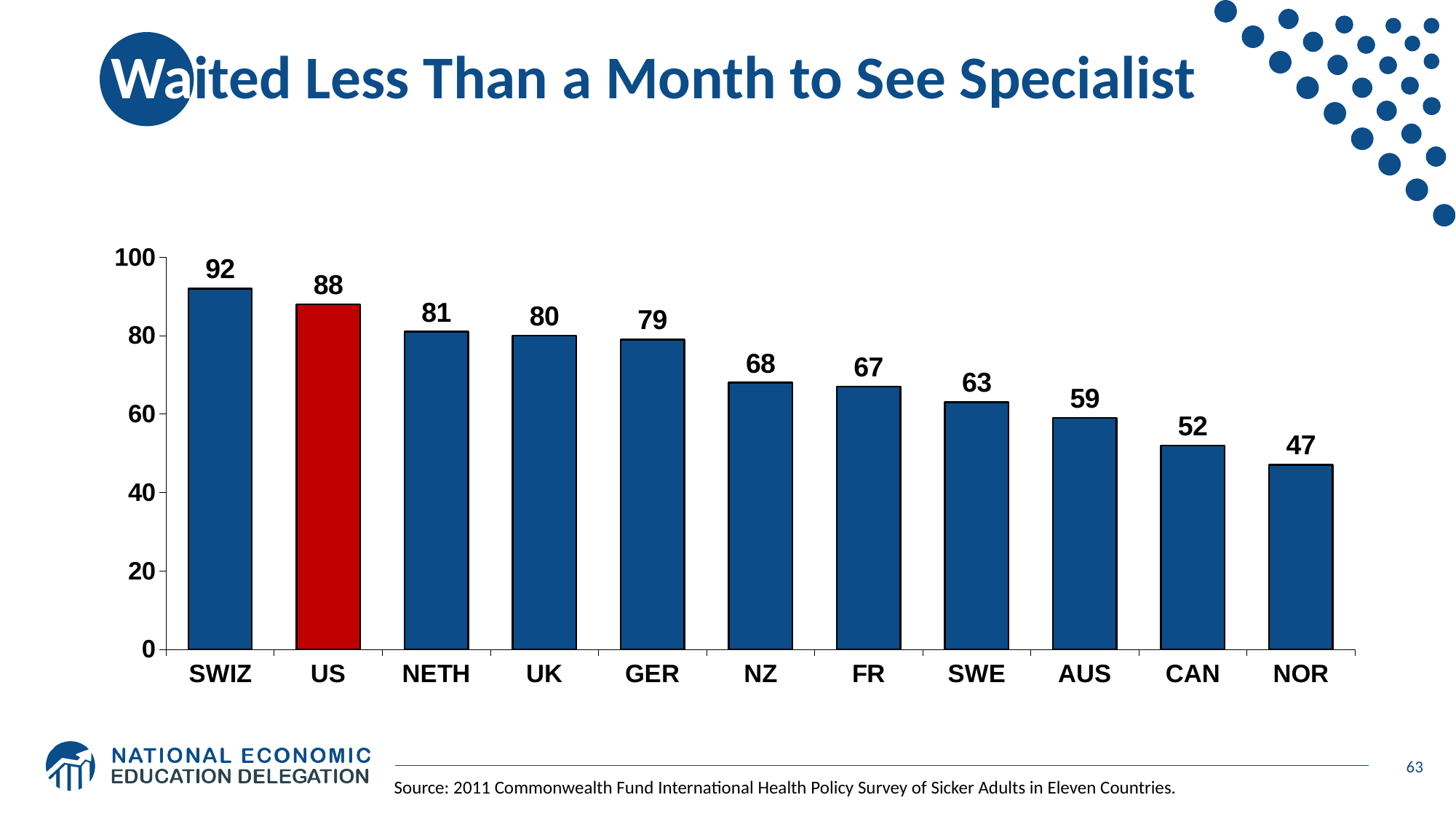
What kind of chart is shown on the slide? bar chart What is the value for the US? 88 How many countries are shown on the chart? 11 Which has a larger value, NZ or SWE? NZ What is the value for NOR? 47 What is the value for GER? 79 Which country has the lowest value? NOR What is the difference between the values for SWIZ and the US? 4 Which bar is coloured red rather than blue? US What is the difference between the values for NETH and CAN? 29 Is the value for AUS greater or less than 60? less Which country has the highest value? SWIZ